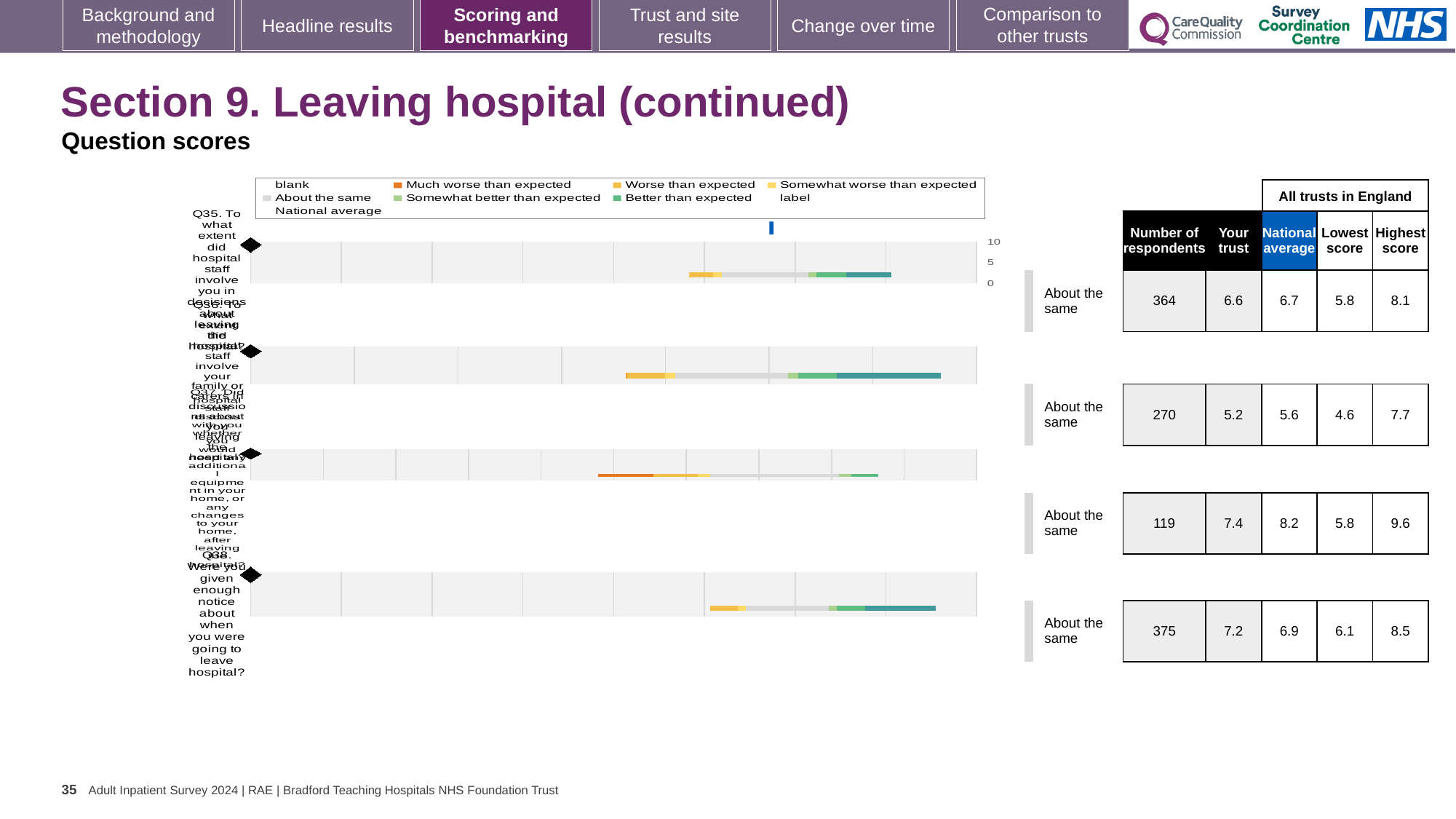
Which question row has the highest 'Your trust' score? Q37 What is the 'Your trust' score for Q36 (the second row of the chart)? 5.2 What benchmark category label is shown next to each of the four question rows? About the same How many respondents are shown for Q35 (the first row of the chart)? 364 What colour does the legend use for 'Much worse than expected'? Orange What kind of chart is used to show the question scores? Bar chart What is the national average score for Q37 (the third row of the chart)? 8.2 What is the difference between the highest score and the lowest score for Q36? 3.1 For Q35, which is larger: the 'Your trust' score or the national average? National average How many question rows are plotted in the chart? 4 What is the highest score among all trusts in England for Q38 (the bottom row of the chart)? 8.5 Which question row has the lowest number of respondents? Q37